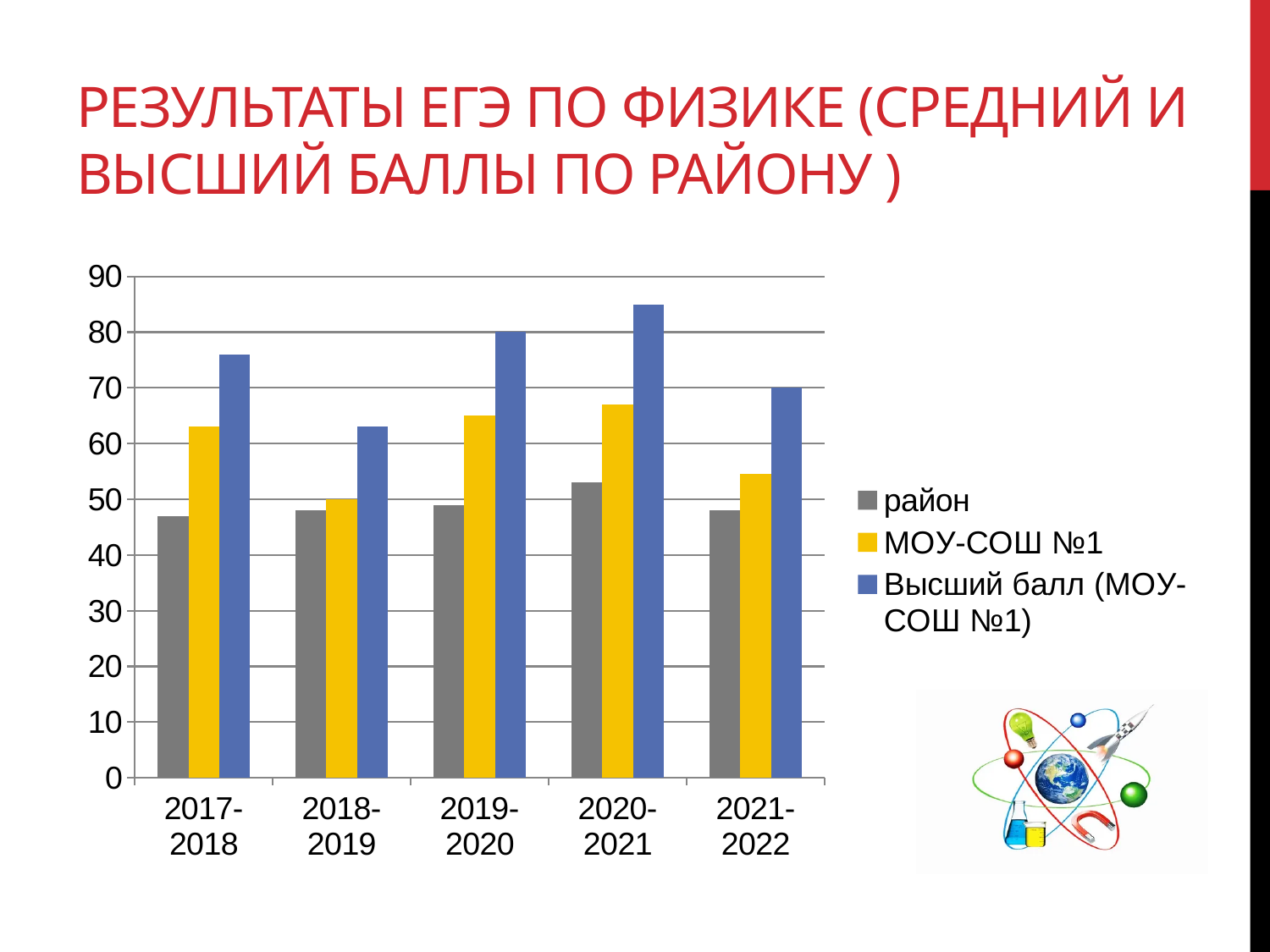
What kind of chart is shown on the slide? bar chart How many series does the legend list? 3 How many academic years are shown on the x axis? 5 Is the value for МОУ-СОШ №1 in 2017-2018 greater or less than 60? greater Which series is shown in blue in the legend? Высший балл (МОУ-СОШ №1) What is the value for Высший балл (МОУ-СОШ №1) in 2019-2020? 80 Which year has the lowest value for Высший балл (МОУ-СОШ №1)? 2018-2019 Which year has the highest value for Высший балл (МОУ-СОШ №1)? 2020-2021 Is the value for район in 2017-2018 greater or less than 50? less What is the value for Высший балл (МОУ-СОШ №1) in 2021-2022? 70 Which is larger: the value for МОУ-СОШ №1 in 2017-2018 or in 2021-2022? 2017-2018 Is the value for район in 2020-2021 greater or less than 50? greater